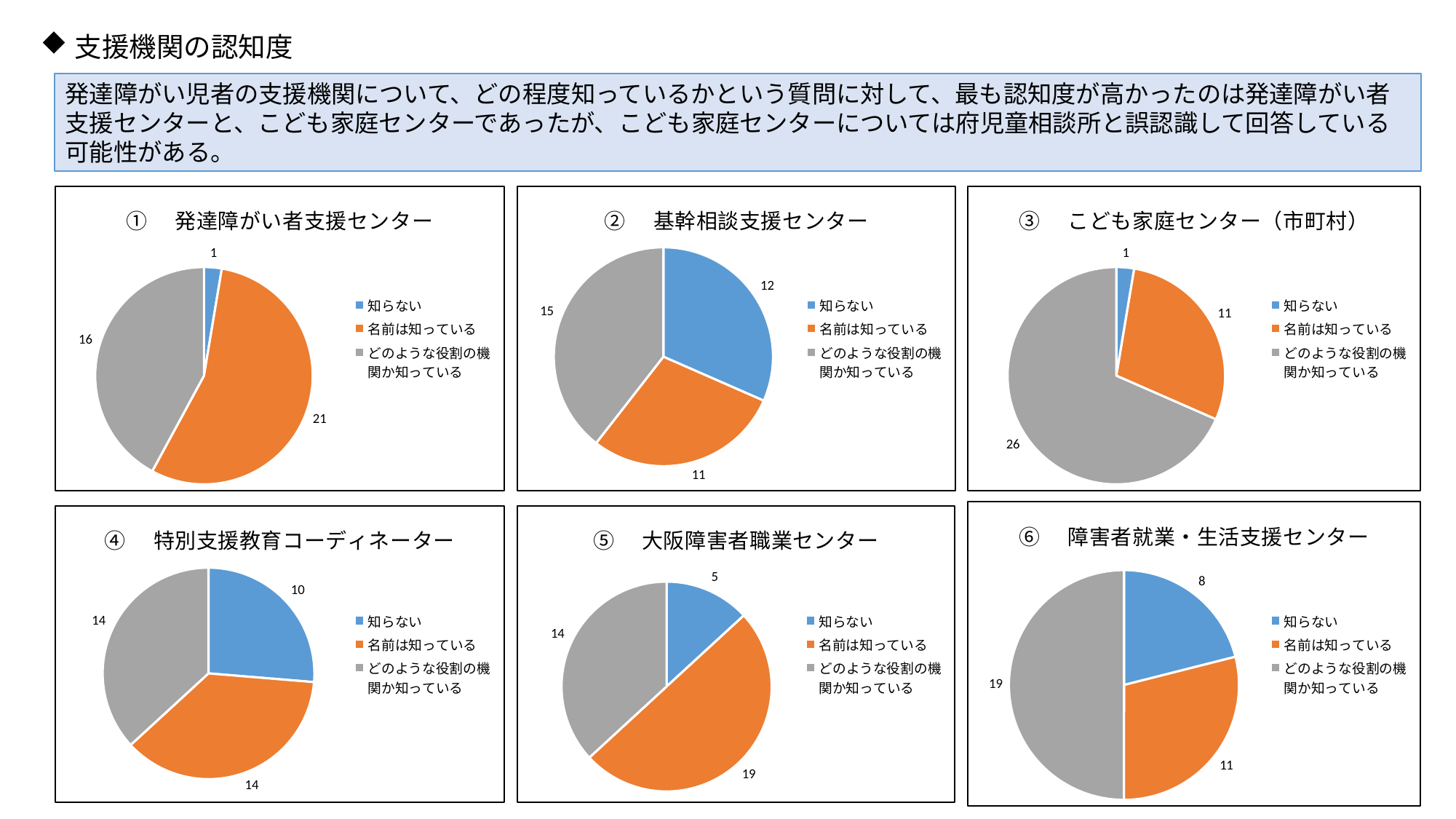
In the chart ④ 特別支援教育コーディネーター, which is larger: 知らない or 名前は知っている? 名前は知っている How many series does the legend list in the chart ② 基幹相談支援センター? 3 In the chart ⑥ 障害者就業・生活支援センター, what colour is the slice for どのような役割の機関か知っている? grey In the chart ⑤ 大阪障害者職業センター, what is the value for 知らない? 5 How many pie charts are shown on the slide? 6 In the chart ③ こども家庭センター（市町村）, what share of the total does 知らない represent? 1/38 What kind of chart is ⑤ 大阪障害者職業センター? pie chart In the chart ③ こども家庭センター（市町村）, what is the value for どのような役割の機関か知っている? 26 In the chart ① 発達障がい者支援センター, what is the difference between 名前は知っている and どのような役割の機関か知っている? 5 In the chart ⑥ 障害者就業・生活支援センター, which category has the smallest value? 知らない In the chart ② 基幹相談支援センター, which category has the largest value? どのような役割の機関か知っている In the chart ① 発達障がい者支援センター, what is the value for 名前は知っている? 21